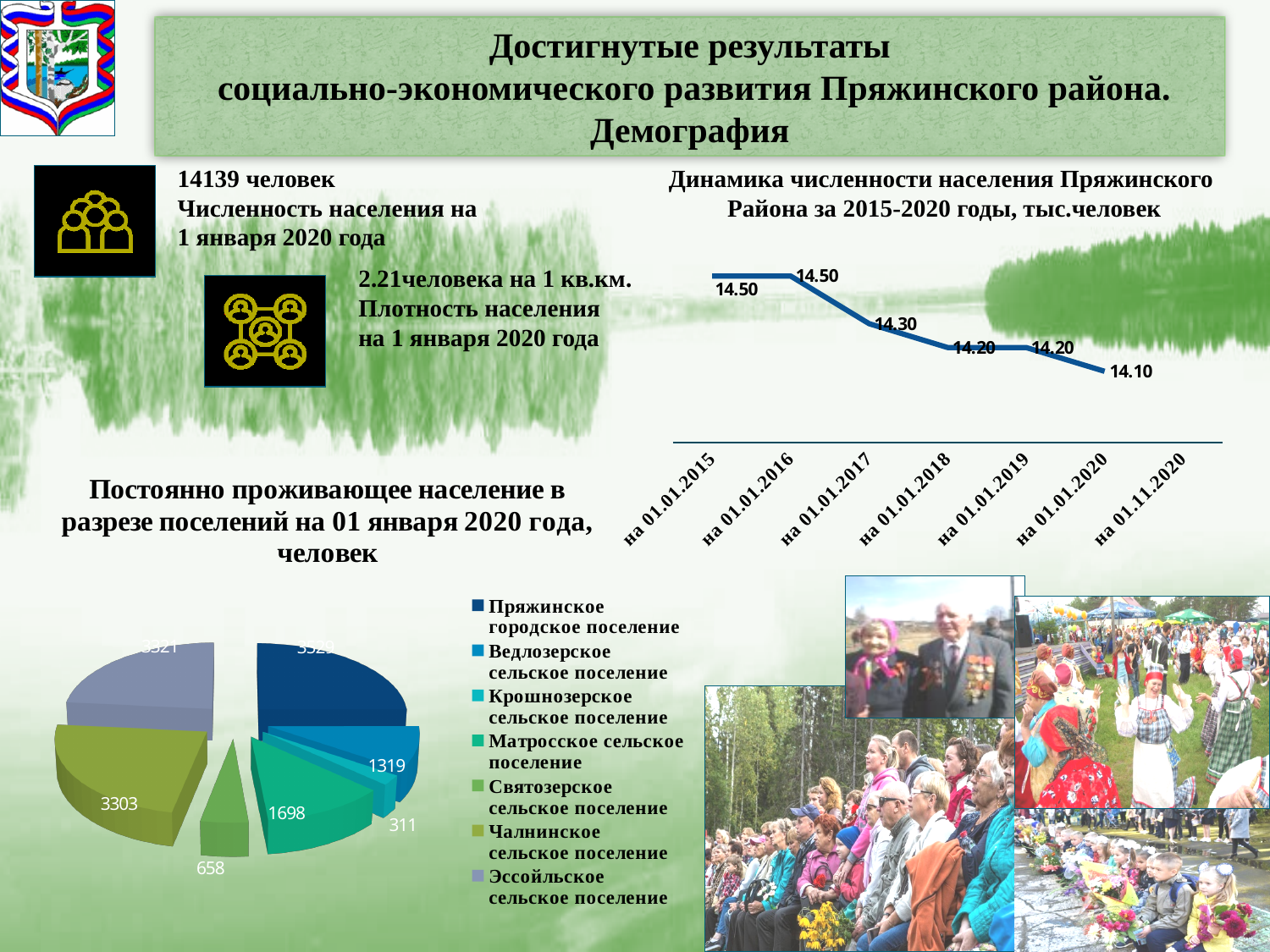
In the 'Динамика численности населения' line chart, do the values rise or fall from left to right? fall In the 'Динамика численности населения' line chart, what is the difference between the highest value (14.50) and the lowest value (14.10)? 0.40 How many entries does the legend of the 'Постоянно проживающее население в разрезе поселений' pie chart list? 7 In the 'Постоянно проживающее население в разрезе поселений' pie chart, which settlement has the smallest value? Крошнозерское сельское поселение In the 'Постоянно проживающее население в разрезе поселений' pie chart, which is larger: Матросское сельское поселение or Ведлозерское сельское поселение? Матросское сельское поселение In the 'Динамика численности населения' line chart, what is the lowest value shown? 14.10 In the 'Динамика численности населения' line chart, what is the value of the last (rightmost) point? 14.10 What kind of chart is the 'Динамика численности населения Пряжинского Района за 2015-2020 годы' chart? line chart What kind of chart is 'Постоянно проживающее население в разрезе поселений на 01 января 2020 года, человек'? pie chart In the 'Динамика численности населения' line chart, what is the highest value shown? 14.50 In the 'Постоянно проживающее население в разрезе поселений' pie chart, what is the difference between Чалнинское сельское поселение (3303) and Святозерское сельское поселение (658)? 2645 In the 'Постоянно проживающее население в разрезе поселений' pie chart, what is the value for Матросское сельское поселение? 1698